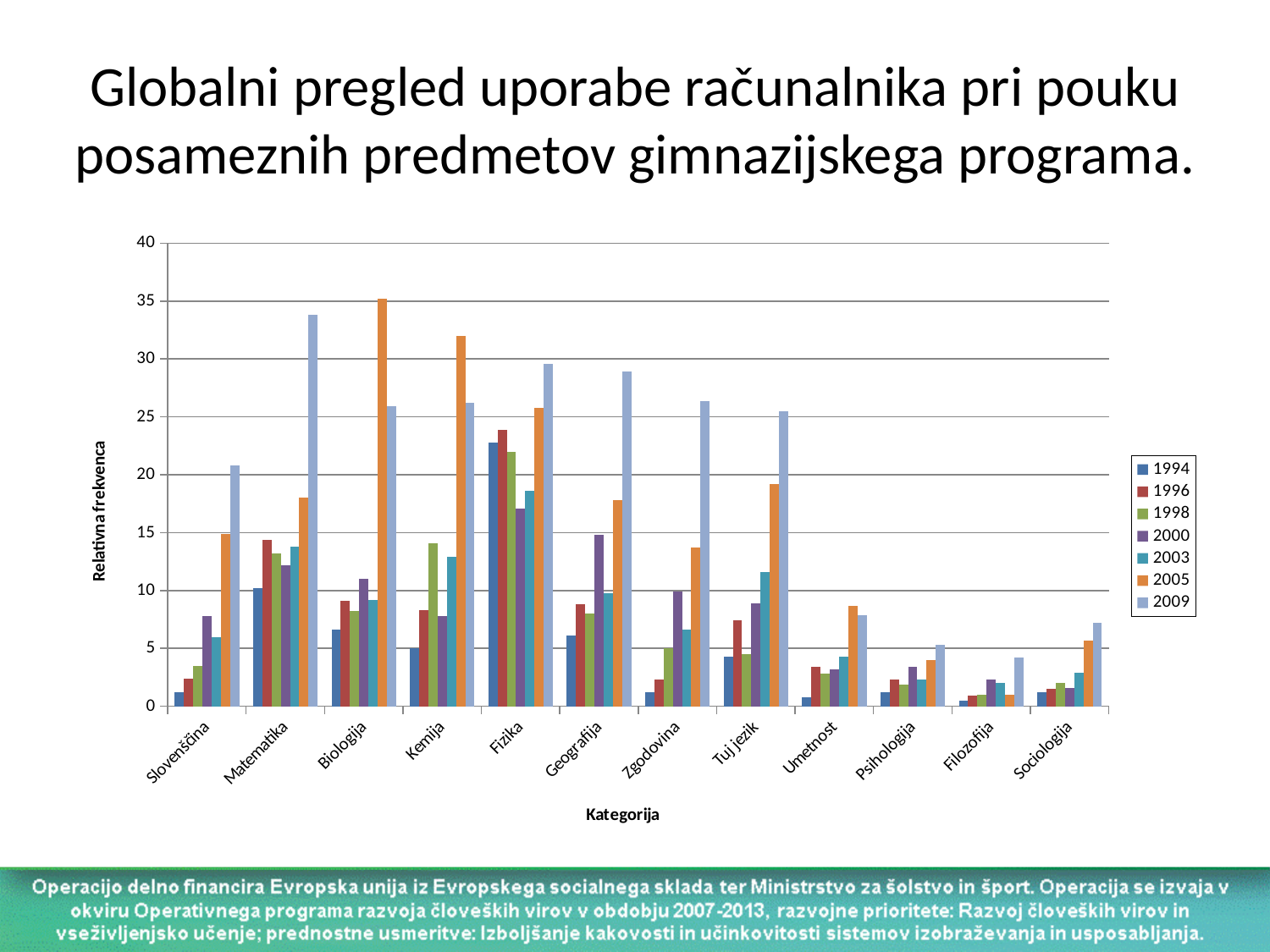
What kind of chart is shown on the slide? bar chart How many categories are shown on the x axis? 12 Which category has the lowest bar for the 2005 series? Filozofija What is the label of the vertical axis? Relativna frekvenca Is the value for Matematika in 2009 greater or less than 30? greater Is the value for Fizika in 1994 greater or less than 20? greater Which category has the highest bar for the 2009 series? Matematika Which category has the highest bar for the 2005 series? Biologija Is the value for Slovenščina in 1994 greater or less than 5? less Which is larger: the 2009 value for Zgodovina or the 2005 value for Zgodovina? 2009 Which is larger: the 2005 value for Biologija or the 2005 value for Kemija? Biologija How many series does the legend list? 7